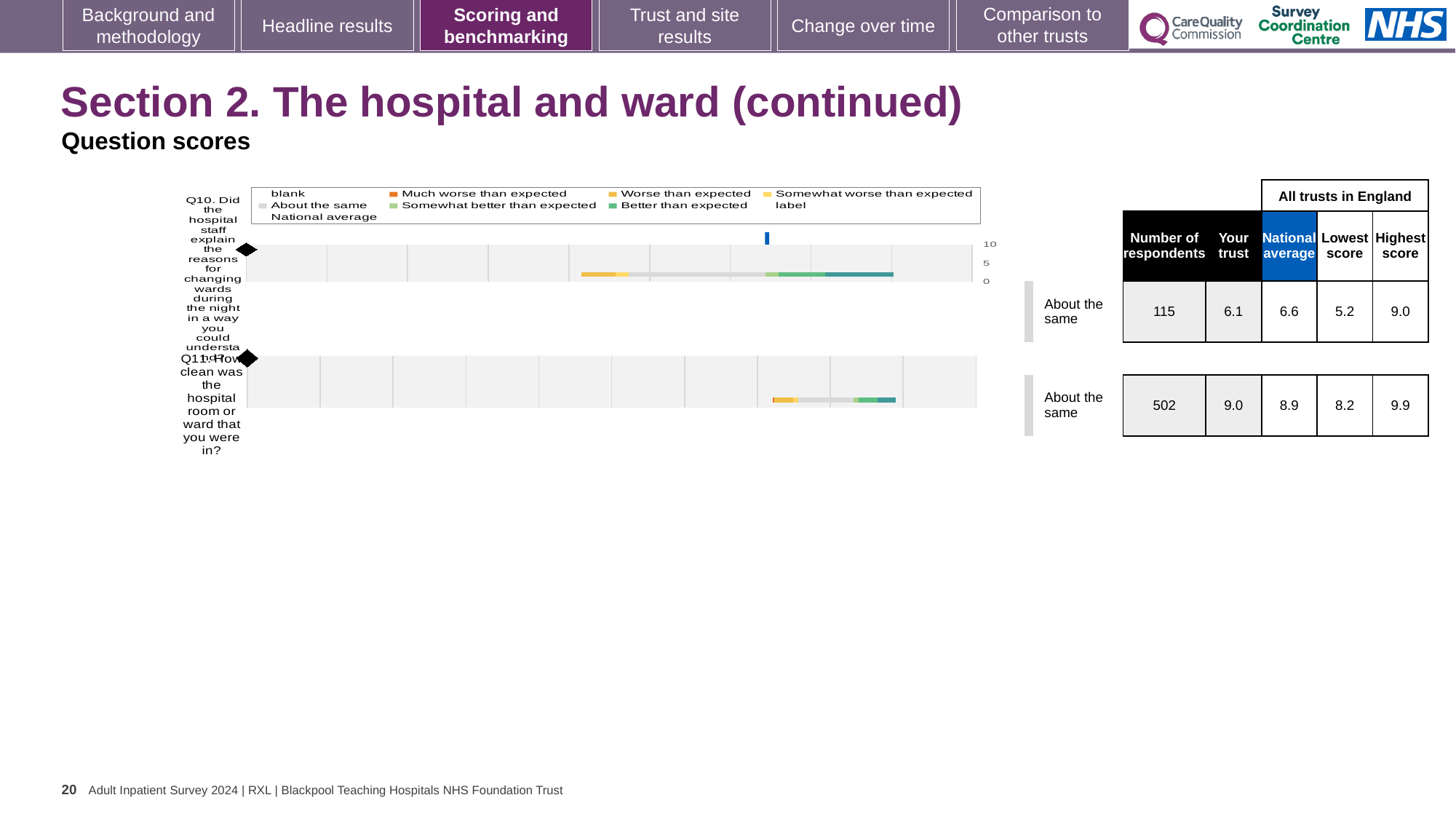
What is the difference between the 'Your trust' score and the national average for Q11? 0.1 According to the table, how many respondents answered Q11? 502 What kind of chart is used to show the Q10 benchmarking result? bar chart According to the table, what is the highest score among all trusts in England for Q11? 9.9 For Q11, which is larger: the 'Your trust' score or the national average? Your trust What is the highest value shown on the axis of the Q10 chart? 10 How many questions (Q10 and Q11) are charted on the slide? 2 According to the table, what is the national average for Q10? 6.6 What benchmark category is shown next to the Q10 chart? About the same According to the table, how many respondents answered Q10? 115 What is the difference between the highest score and the lowest score for Q10? 3.8 According to the table, what is the 'Your trust' score for Q10? 6.1